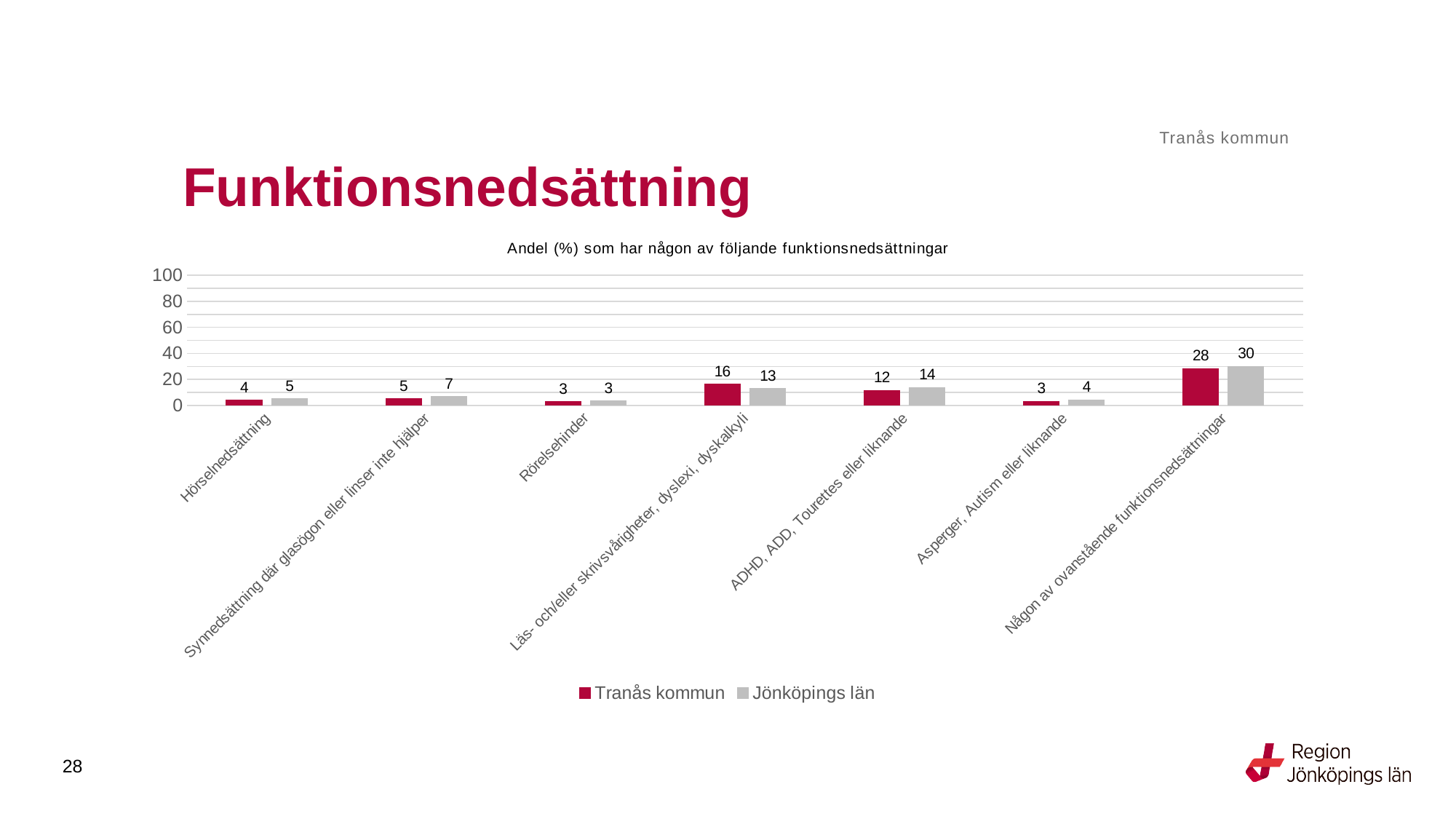
How many series does the legend list? 2 What is the difference between Jönköpings län and Tranås kommun for Någon av ovanstående funktionsnedsättningar? 2 What is the value for Tranås kommun for Hörselnedsättning? 4 What is the difference between Tranås kommun and Jönköpings län for Läs- och/eller skrivsvårigheter, dyslexi, dyskalkyli? 3 Is the value for Jönköpings län for Någon av ovanstående funktionsnedsättningar greater or less than 20? greater Which category has the lowest value for Jönköpings län? Rörelsehinder What is the value for Tranås kommun for Läs- och/eller skrivsvårigheter, dyslexi, dyskalkyli? 16 What kind of chart is shown on the slide? bar chart Which category has the highest value for Jönköpings län? Någon av ovanstående funktionsnedsättningar How many categories are shown on the x axis? 7 Which is larger for Synnedsättning där glasögon eller linser inte hjälper: Tranås kommun or Jönköpings län? Jönköpings län What is the value for Jönköpings län for ADHD, ADD, Tourettes eller liknande? 14